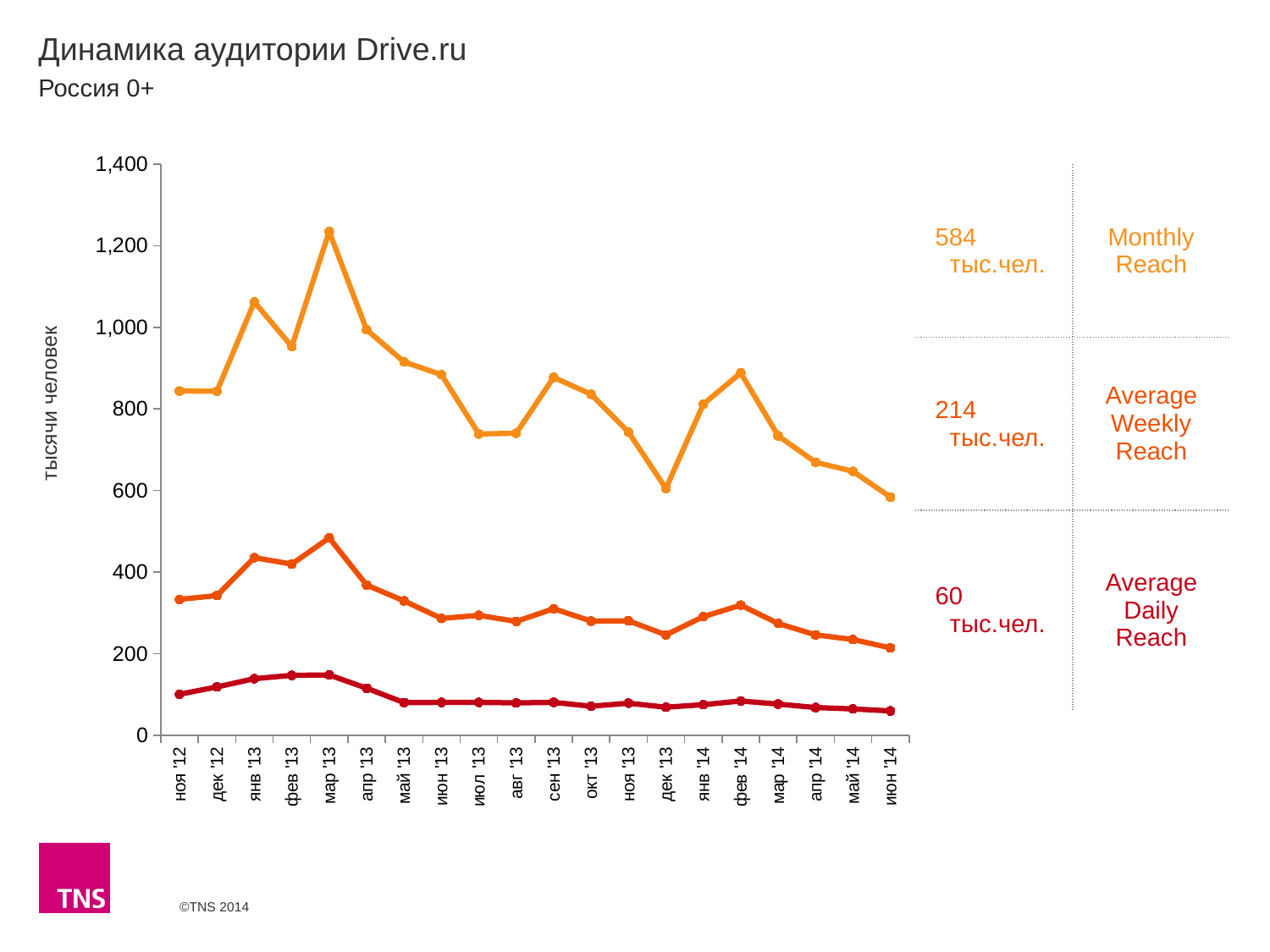
How many monthly data points are plotted along the x axis? 20 Is the Monthly Reach value for дек '13 greater or less than 800? less What Monthly Reach value is printed in the panel to the right of the chart? 584 тыс.чел. Is the Average Daily Reach value for мар '13 greater or less than 200? less Which month has the higher Monthly Reach, янв '13 or фев '13? янв '13 Is the Monthly Reach value for мар '13 greater or less than 1,000? greater What type of chart is shown on the slide? line chart In which month does the Average Weekly Reach line reach its highest value? мар '13 Does the Monthly Reach line rise or fall from фев '14 to июн '14? fall In which month does the Monthly Reach line reach its highest value? мар '13 How many series are plotted on the chart? 3